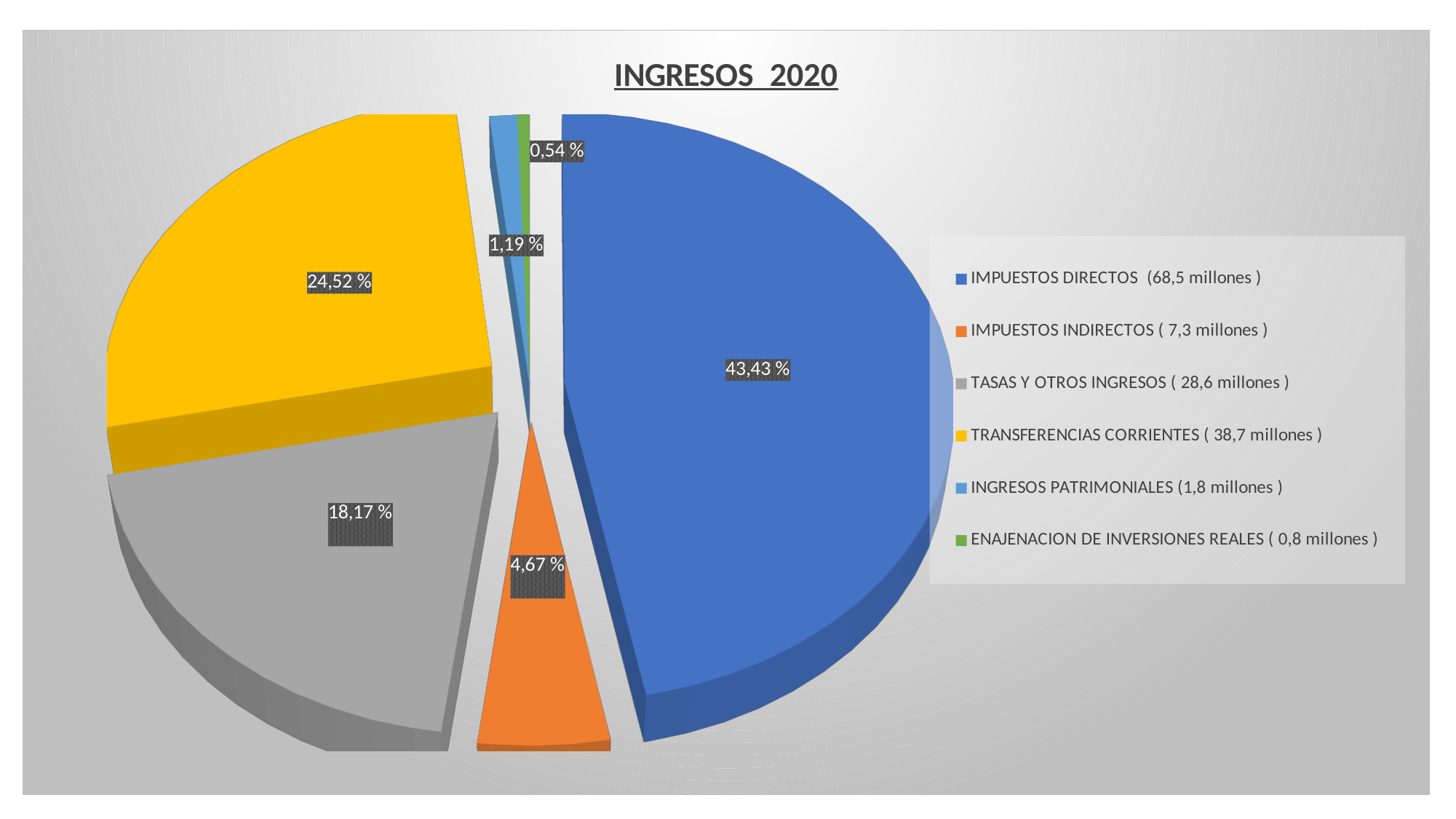
What percentage share does TASAS Y OTROS INGRESOS have? 18,17 % What percentage share does ENAJENACION DE INVERSIONES REALES have? 0,54 % What percentage share does IMPUESTOS INDIRECTOS have? 4,67 % Which category has the largest share of the pie? IMPUESTOS DIRECTOS How many slices does the pie chart have? 6 What is the title of the chart? INGRESOS 2020 Which has a larger share, TRANSFERENCIAS CORRIENTES or TASAS Y OTROS INGRESOS? TRANSFERENCIAS CORRIENTES What amount in millions does the legend give for INGRESOS PATRIMONIALES? 1,8 millones Which category has the smallest share of the pie? ENAJENACION DE INVERSIONES REALES What type of chart is shown on the slide? Pie chart